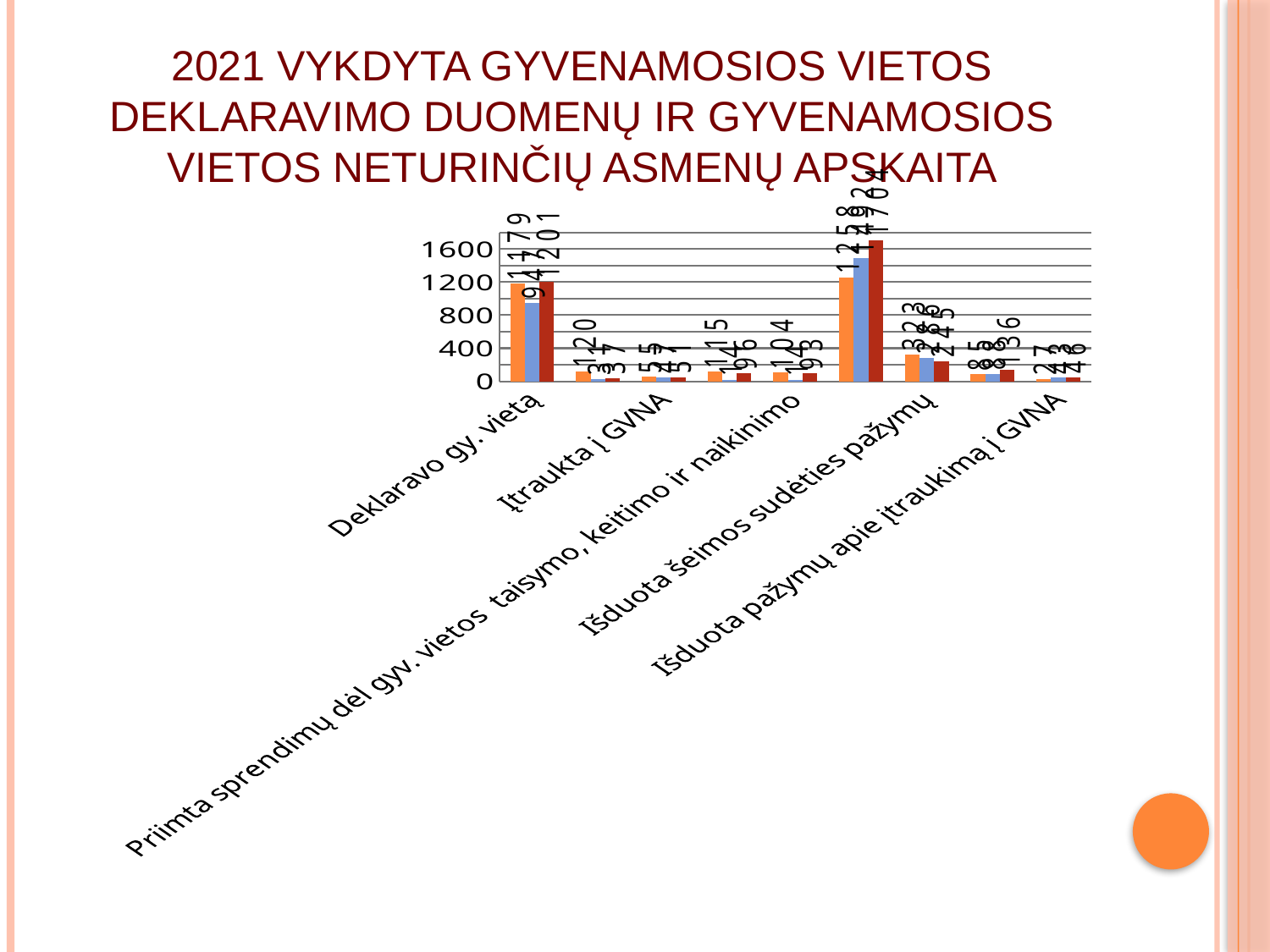
What is the value of the blue bar for "Išduota šeimos sudėties pažymų"? 286 Are the bars for "Įtraukta į GVNA" greater or less than 400? less What is the value of the blue bar for "Deklaravo gy. vietą"? 947 Which is larger: the dark red bar for "Deklaravo gy. vietą" or the dark red bar for "Išduota šeimos sudėties pažymų"? Deklaravo gy. vietą What is the difference between the dark red bar (1201) and the blue bar (941) for "Deklaravo gy. vietą"? 254 What is the value of the orange bar for "Deklaravo gy. vietą"? 1179 What kind of chart is shown on the slide? bar chart Is the value of the dark red bar for "Išduota šeimos sudėties pažymų" greater or less than 1600? less What is the value of the dark red bar for "Išduota šeimos sudėties pažymų"? 245 How many groups of bars are plotted on the chart? 9